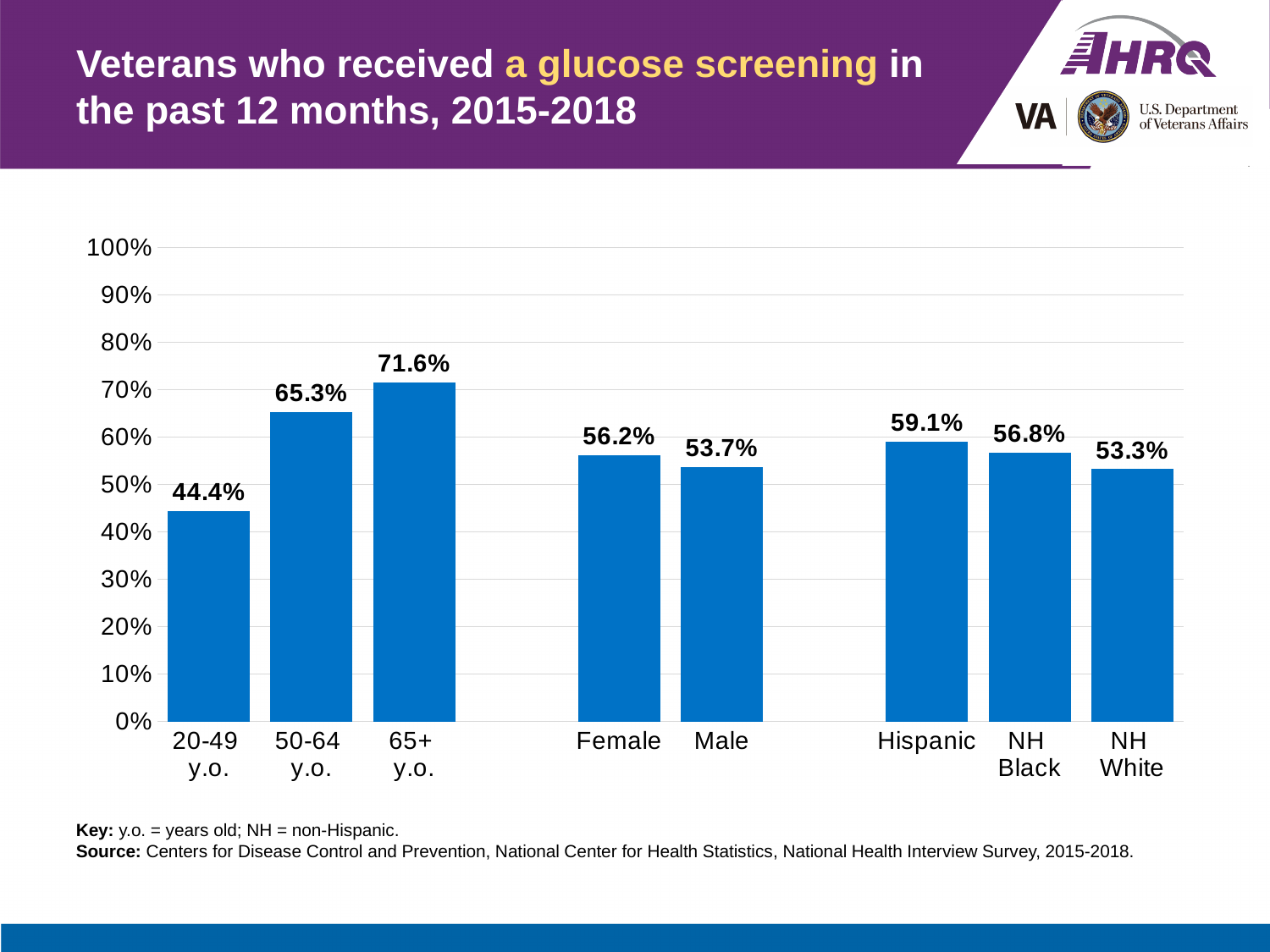
What kind of chart is shown on the slide? Bar chart Which category has the lowest value on the chart? 20-49 y.o. Is the value for 50-64 y.o. greater or less than 60%? greater Which is larger, the value for Hispanic or the value for NH White? Hispanic What is the difference between the values for Female and Male veterans? 2.5% Which category has the highest value on the chart? 65+ y.o. What is the value shown for Female veterans? 56.2% Do the values rise or fall across the three age groups from 20-49 y.o. to 65+ y.o.? Rise What is the difference between the values for 65+ y.o. and 20-49 y.o.? 27.2% What percentage of veterans aged 20-49 y.o. received a glucose screening in the past 12 months? 44.4% What is the value shown for NH Black veterans? 56.8% How many categories are shown on the chart? 8